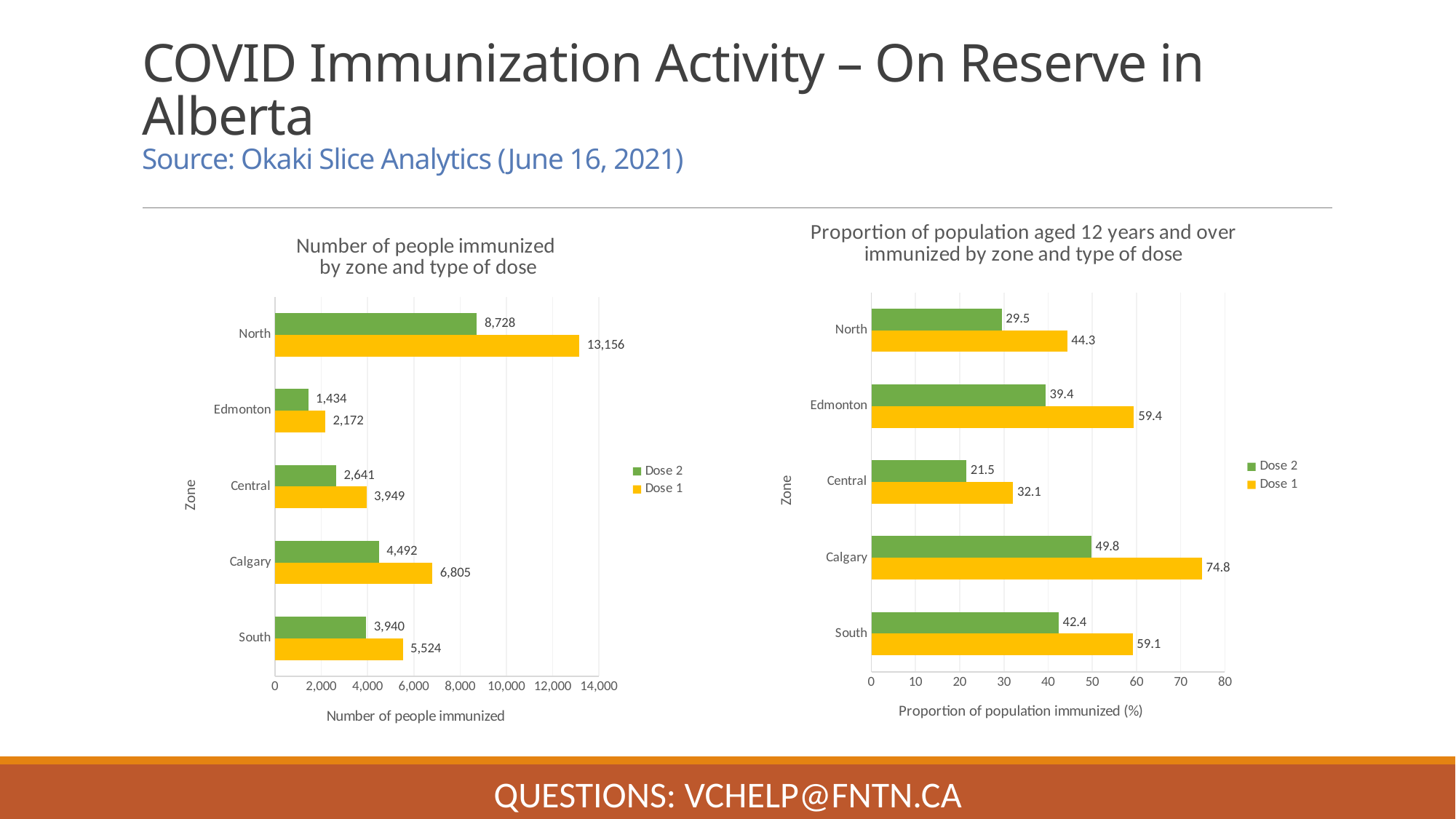
In the 'Number of people immunized by zone and type of dose' chart, what is the Dose 2 value for Calgary? 4,492 What type of chart is the 'Proportion of population aged 12 years and over immunized by zone and type of dose' chart? Bar chart In the 'Number of people immunized by zone and type of dose' chart, what is the Dose 1 value for North? 13,156 In the 'Proportion of population aged 12 years and over immunized by zone and type of dose' chart, which is larger: the Dose 1 value for Edmonton or the Dose 1 value for South? Edmonton In the 'Number of people immunized by zone and type of dose' chart, which zone has the lowest Dose 2 value? Edmonton In the 'Proportion of population aged 12 years and over immunized by zone and type of dose' chart, which zone has the highest Dose 2 value? Calgary In the 'Number of people immunized by zone and type of dose' chart, what is the difference between Dose 1 and Dose 2 for South? 1,584 In the 'Proportion of population aged 12 years and over immunized by zone and type of dose' chart, what is the Dose 1 value for Calgary? 74.8 In the 'Proportion of population aged 12 years and over immunized by zone and type of dose' chart, what is the Dose 2 value for Central? 21.5 How many series does the legend of the 'Number of people immunized by zone and type of dose' chart list? 2 In the 'Proportion of population aged 12 years and over immunized by zone and type of dose' chart, what is the difference between Dose 1 and Dose 2 for North? 14.8 In the 'Number of people immunized by zone and type of dose' chart, how many zones are shown? 5